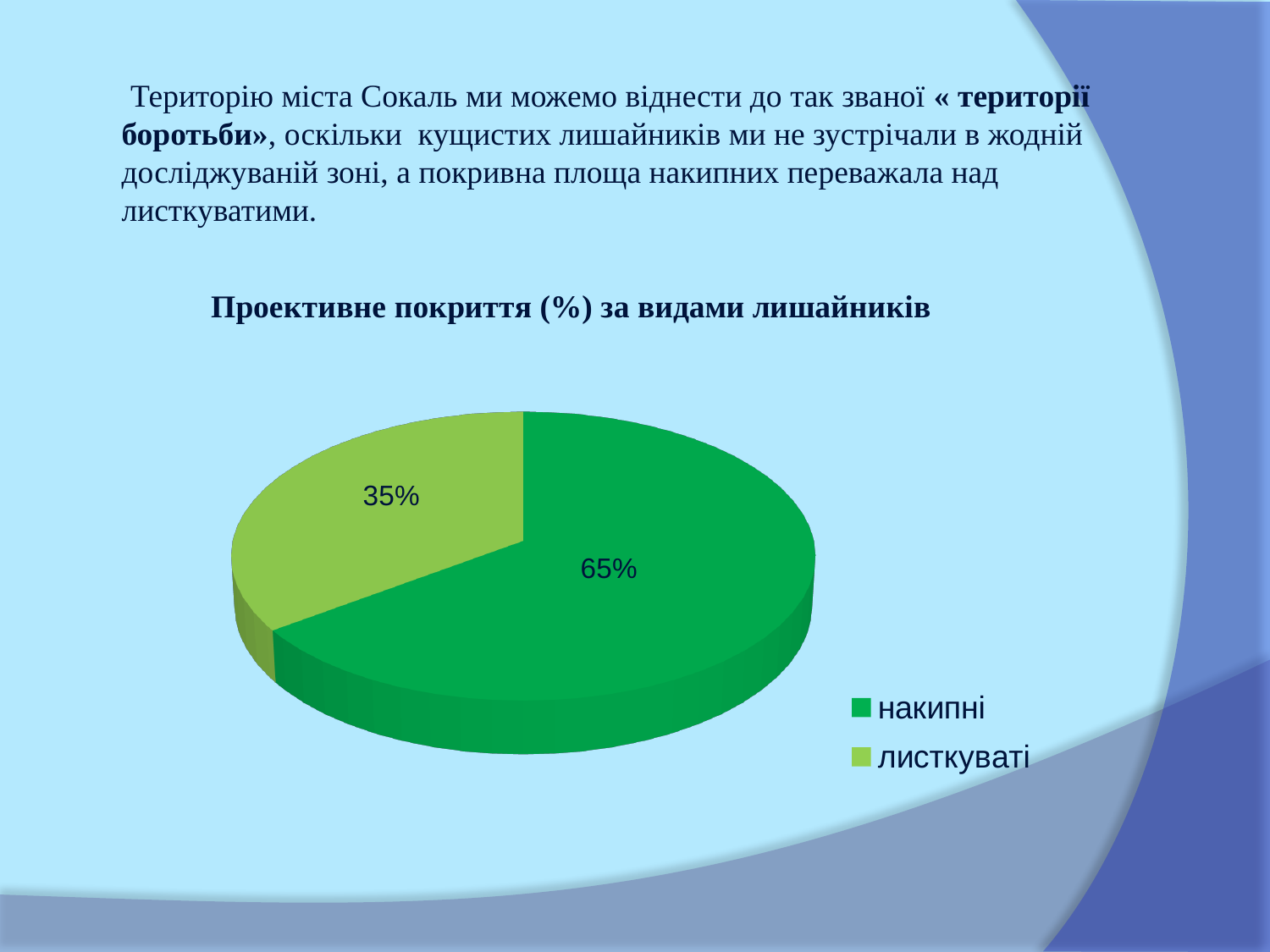
Which category has the smallest share of the pie? листкуваті What is the value for листкуваті in the pie chart? 35% Which is larger, the share for накипні or for листкуваті? накипні How many entries does the legend list? 2 What is the difference between the shares of накипні and листкуваті? 30% How many categories does the pie chart show? 2 What is the value for накипні in the pie chart? 65% Which category is shown in the lighter green colour? листкуваті What share of the pie does the накипні slice represent? 65% What type of chart is shown on the slide? pie chart What is the title of the chart? Проективне покриття (%) за видами лишайників Which category has the largest share of the pie? накипні